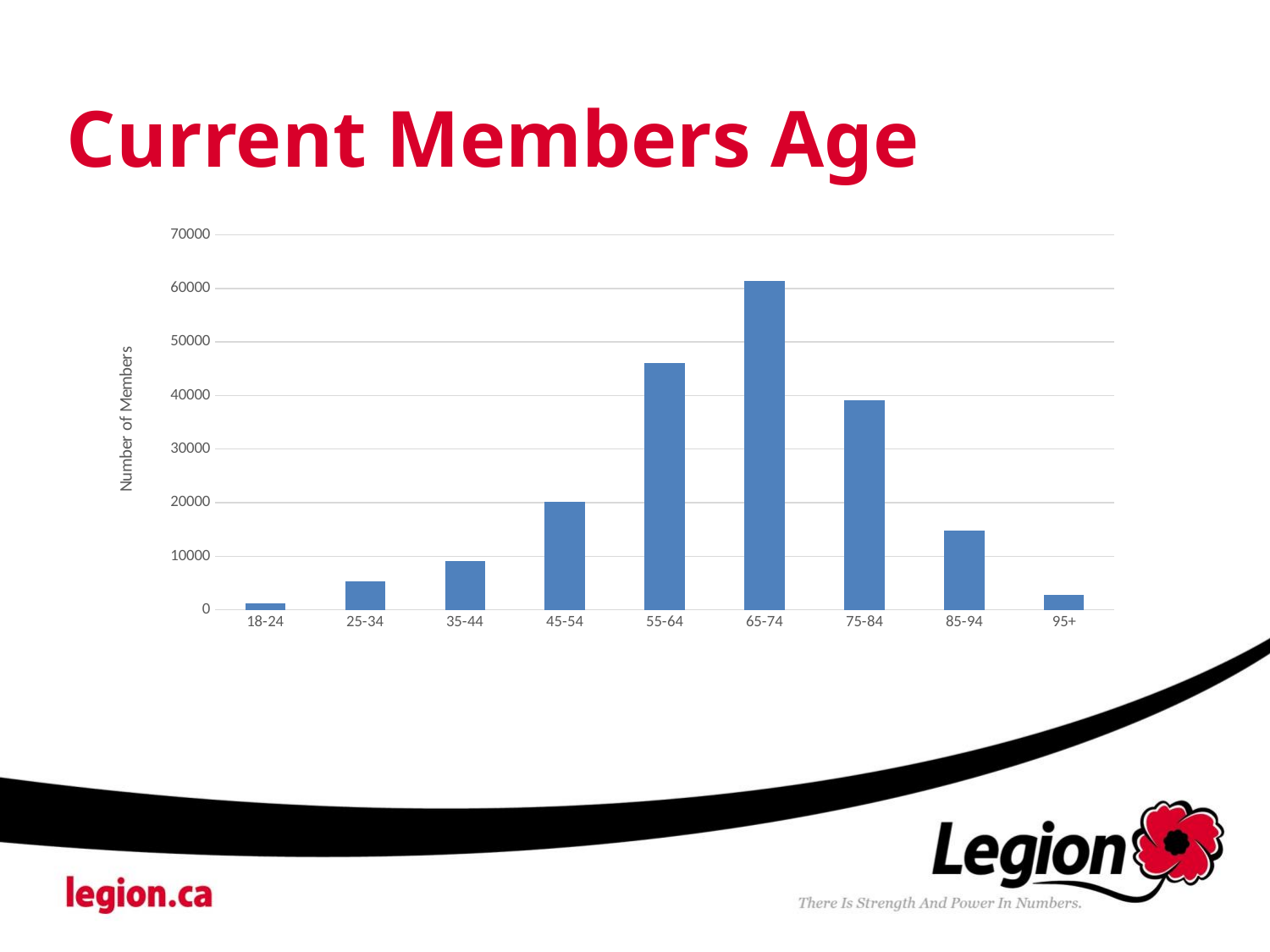
Is the number of members aged 55-64 greater or less than 40000? greater Is the number of members aged 75-84 greater or less than 40000? less Which age group has more members, 55-64 or 75-84? 55-64 How many age groups are shown on the x axis? 9 Is the number of members aged 85-94 greater or less than 10000? greater Which age group has more members, 25-34 or 95+? 25-34 What is the label on the vertical axis of the chart? Number of Members Which age group has the highest number of members? 65-74 What kind of chart is shown on the slide? bar chart Which age group has the lowest number of members? 18-24